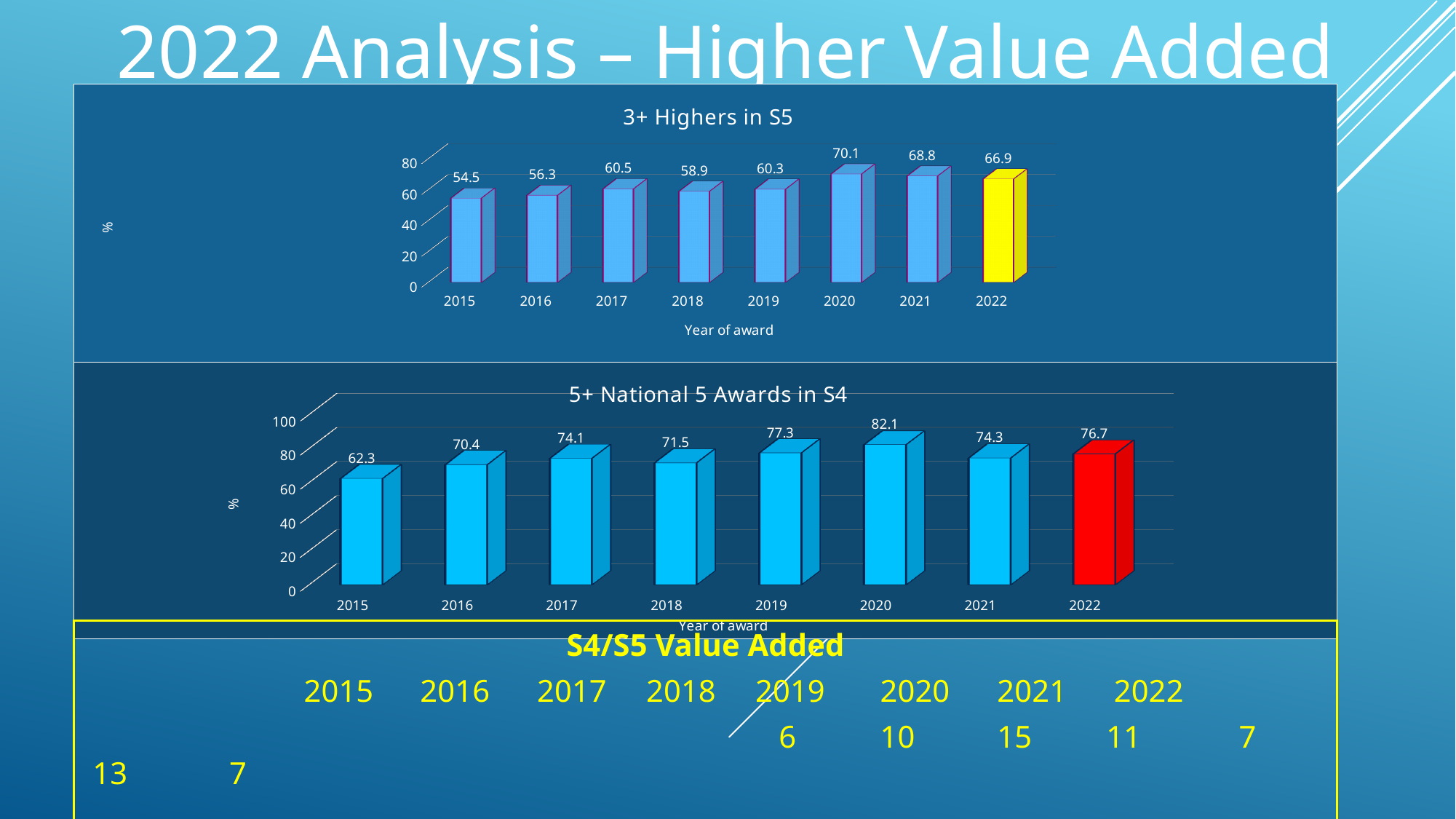
In the '3+ Highers in S5' chart, what is the difference between the 2020 and 2021 values? 1.3 In the '5+ National 5 Awards in S4' chart, what is the difference between the 2020 and 2015 values? 19.8 In the '3+ Highers in S5' chart, which year has the highest value? 2020 What kind of chart is the '3+ Highers in S5' chart? Bar chart In the '3+ Highers in S5' chart, which year has the lowest value? 2015 In the '5+ National 5 Awards in S4' chart, which year has the lowest value? 2015 In the '5+ National 5 Awards in S4' chart, what colour is the bar for 2022? Red In the '5+ National 5 Awards in S4' chart, which is larger, the value for 2021 or the value for 2022? 2022 In the '5+ National 5 Awards in S4' chart, what is the value for 2019? 77.3 In the '5+ National 5 Awards in S4' chart, which year has the highest value? 2020 In the '3+ Highers in S5' chart, what is the value for 2022? 66.9 In the '3+ Highers in S5' chart, how many years are plotted? 8